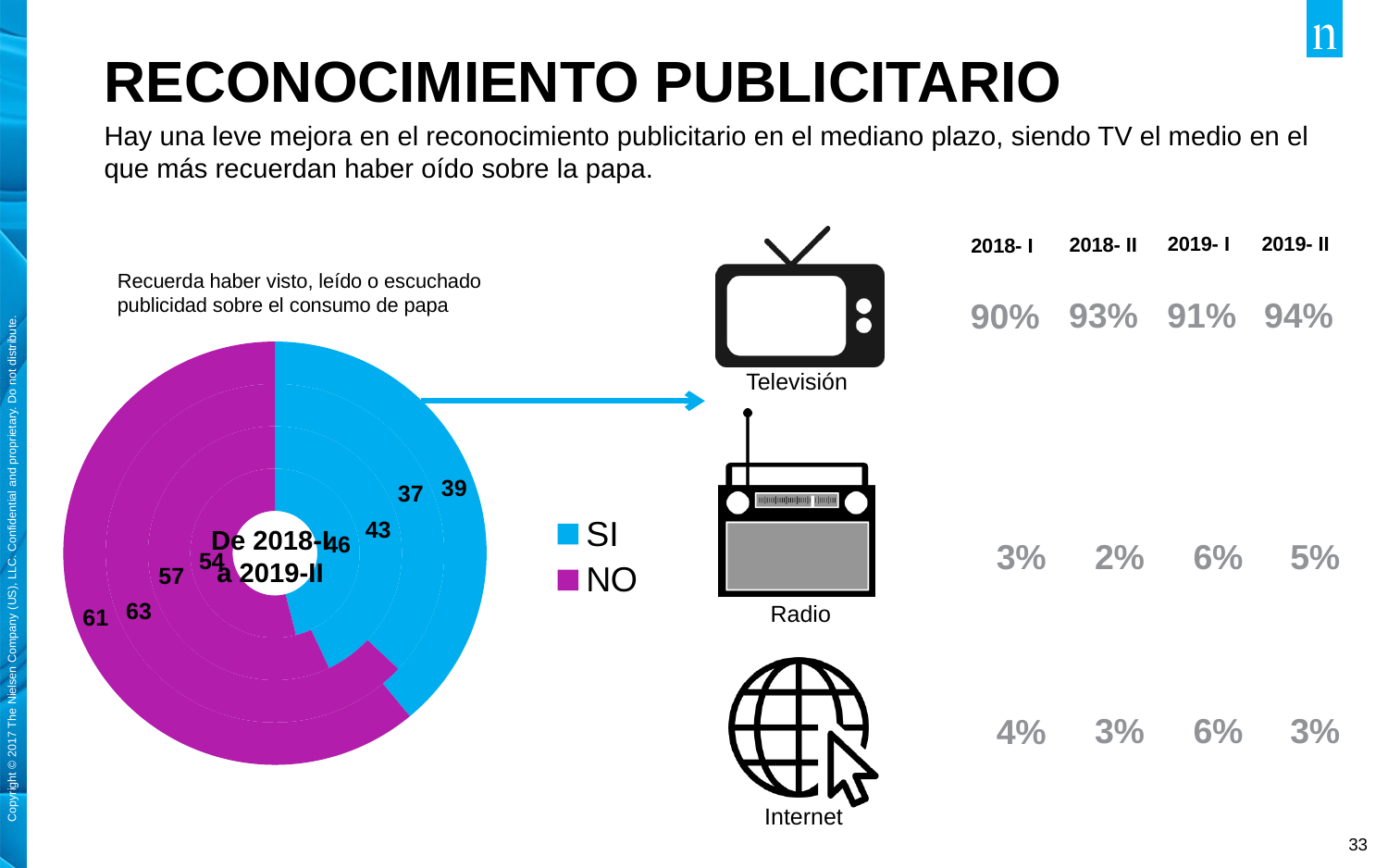
In the outermost ring of the doughnut chart, what is the value for NO? 61 How many series does the legend of the doughnut chart list? 2 What are the two legend entries of the doughnut chart? SI and NO In the innermost ring of the doughnut chart, which is larger, SI or NO? NO In the innermost ring of the doughnut chart, what is the value for SI? 46 How many rings does the doughnut chart have? 4 Which colour represents SI in the doughnut chart? blue In the innermost ring of the doughnut chart, what is the difference between the NO value and the SI value? 8 What is the highest SI value shown across all rings of the doughnut chart? 46 What kind of chart is shown on the slide? doughnut chart In the outermost ring of the doughnut chart, what is the value for SI? 39 In the innermost ring of the doughnut chart, what is the value for NO? 54